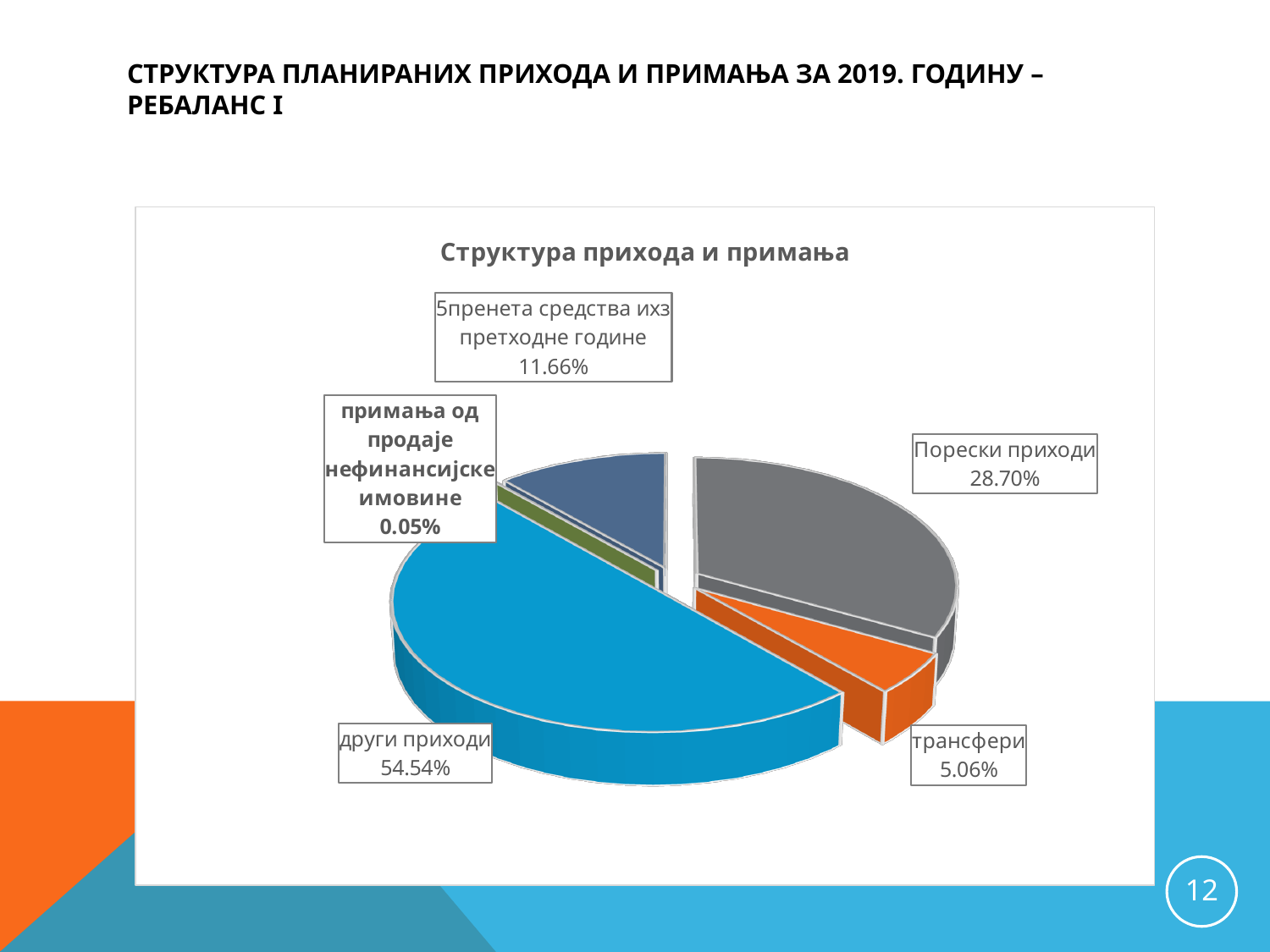
What share of the pie is пренета средства из претходне године? 11.66% What is the title of the chart? Структура прихода и примања Which slice of the pie is the smallest? примања од продаје нефинансијске имовине How many slices does the pie chart have? 5 Which slice of the pie is the largest? други приходи What is the difference in percentage points between други приходи and Порески приходи? 25.84 What share of the pie is Порески приходи? 28.70% What share of the pie is трансфери? 5.06% What share of the pie is други приходи? 54.54% What kind of chart is shown on the slide? pie chart What share of the pie is примања од продаје нефинансијске имовине? 0.05% Which is larger, Порески приходи or трансфери? Порески приходи